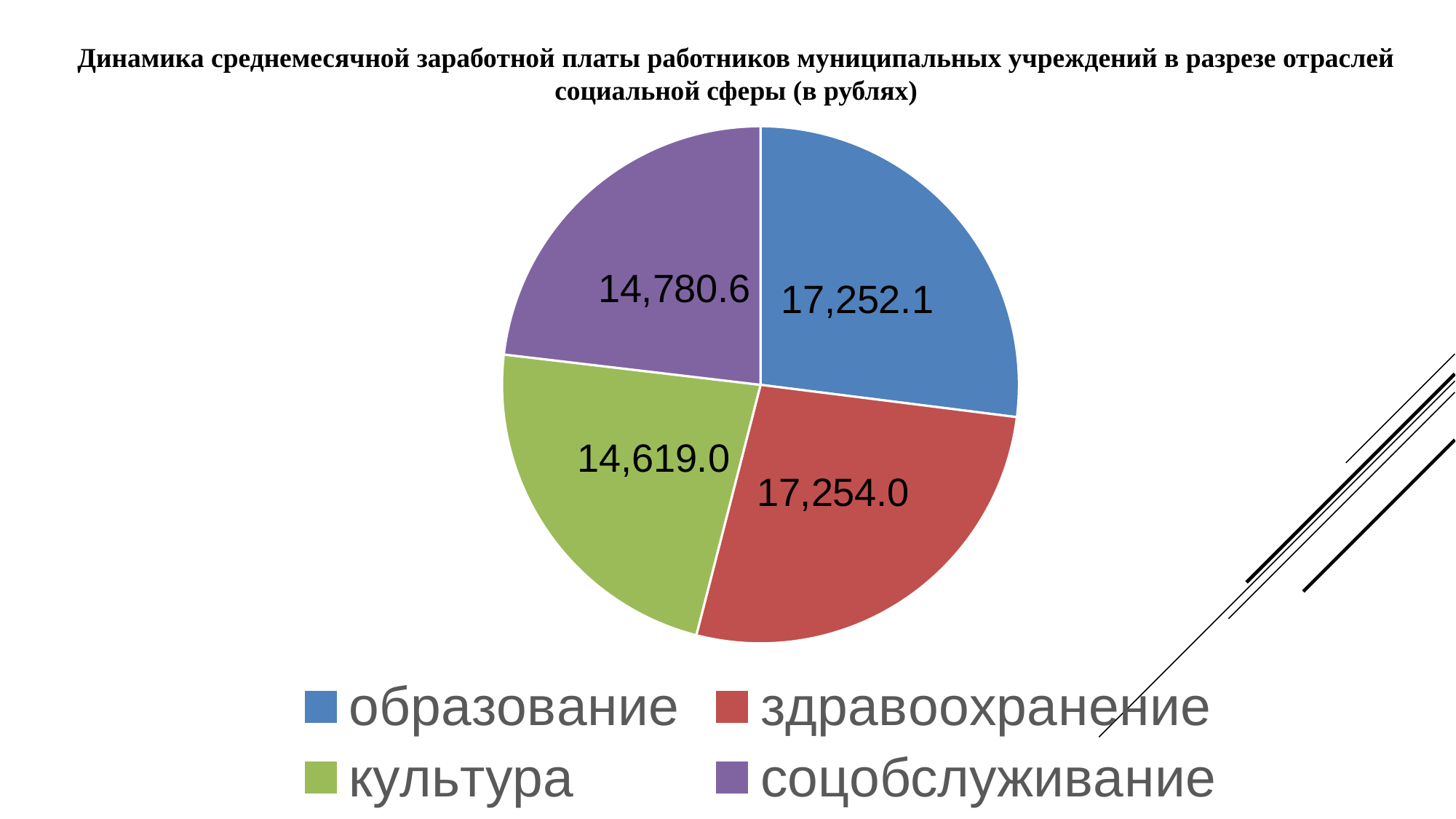
What is the value shown for культура? 14,619.0 What is the value shown for соцобслуживание? 14,780.6 Which category has the highest value? здравоохранение What is the difference between the values for соцобслуживание and культура? 161.6 Which category has the lowest value? культура What is the value shown for здравоохранение? 17,254.0 Which colour represents здравоохранение in the legend? red What is the value shown for образование? 17,252.1 What kind of chart is shown on the slide? pie chart Which is larger, the value for образование or the value for культура? образование How many slices does the pie chart have? 4 What is the difference between the values for образование and культура? 2,633.1